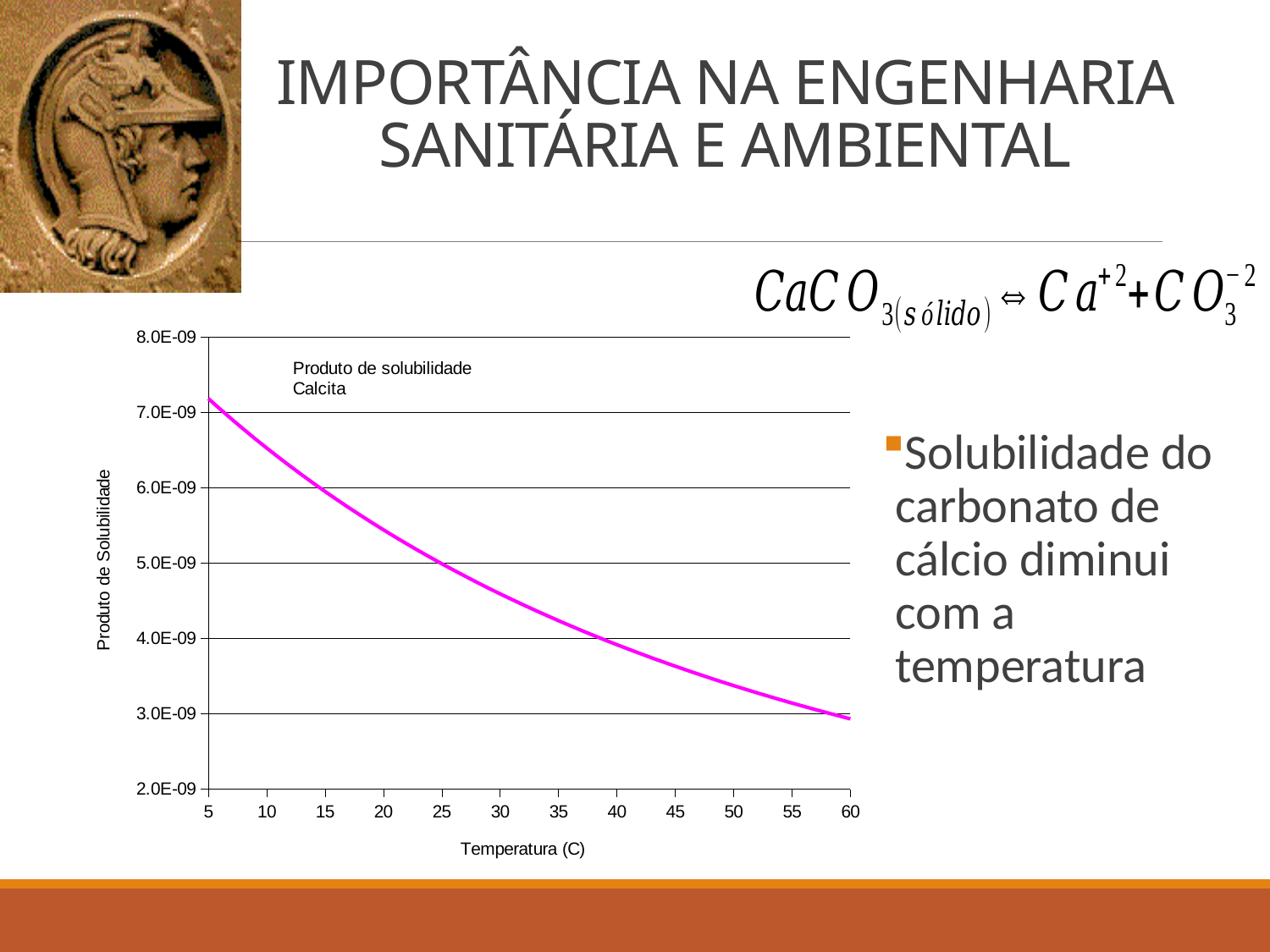
At which temperature on the x axis is the solubility product lowest? 60 Is the solubility product at 30 °C greater or less than 5.0E-09? less Is the solubility product at 50 °C greater or less than 4.0E-09? less Is the solubility product at 10 °C greater or less than 6.0E-09? greater What kind of chart is shown on the slide? line chart What is the title shown inside the chart area? Produto de solubilidade Calcita What is the title of the x axis of the chart? Temperatura (C) Does the solubility product of calcite rise or fall as temperature increases along the x axis? fall At which temperature on the x axis is the solubility product highest? 5 Which is larger, the solubility product at 20 °C or at 45 °C? 20 °C